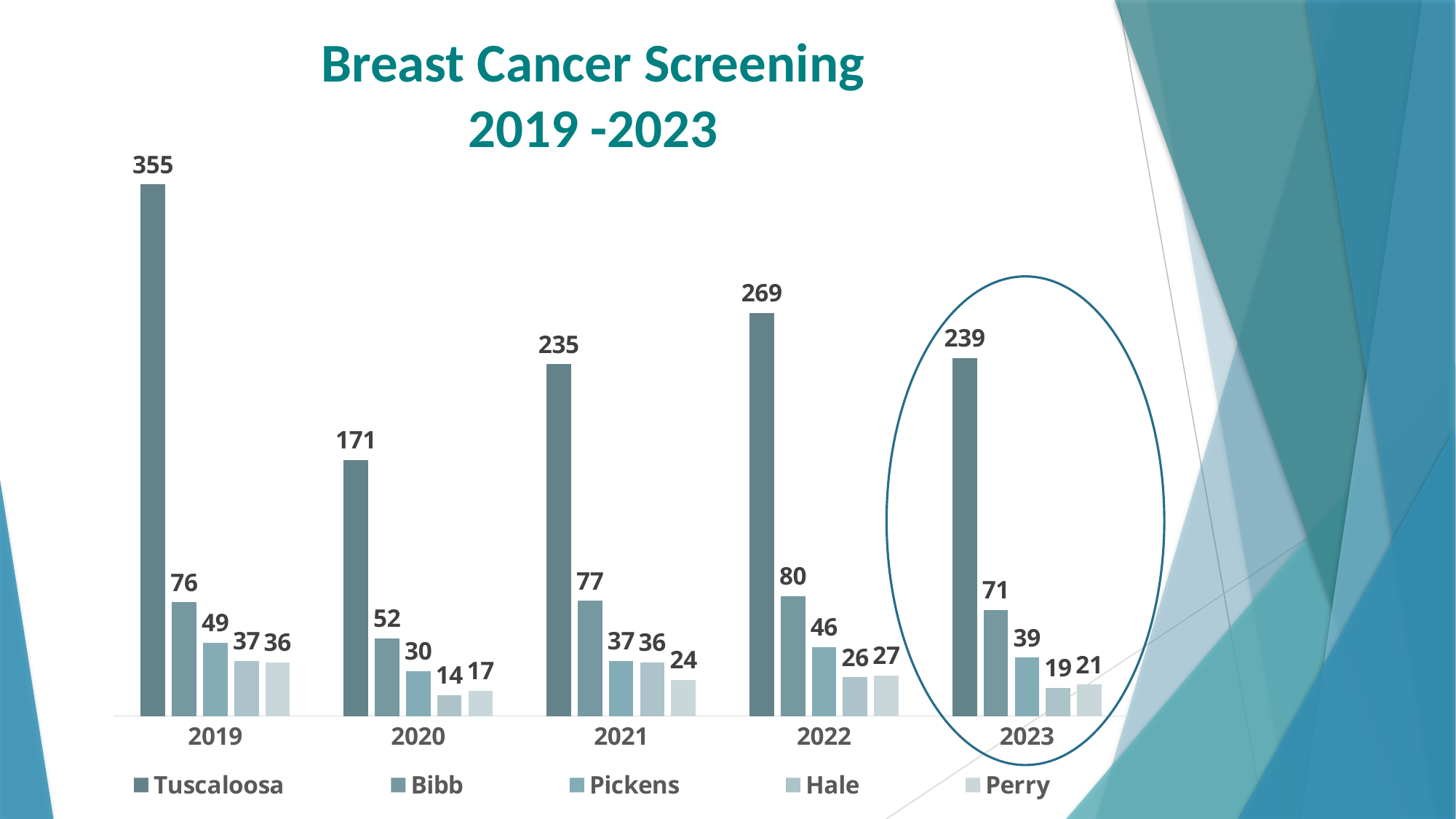
What is the value for Bibb in 2022? 80 In which year was the Tuscaloosa value lowest? 2020 In which year was the Tuscaloosa value highest? 2019 What is the value for Hale in 2020? 14 What is the value for Tuscaloosa in 2019? 355 What is the value for Perry in 2023? 21 How many years are shown on the x axis? 5 How many series does the legend list? 5 What kind of chart is shown on the slide? Bar chart Which is larger, the Pickens value in 2021 or the Pickens value in 2023? 2023 What is the title of the chart? Breast Cancer Screening 2019 -2023 What is the difference between the Tuscaloosa values for 2019 and 2020? 184